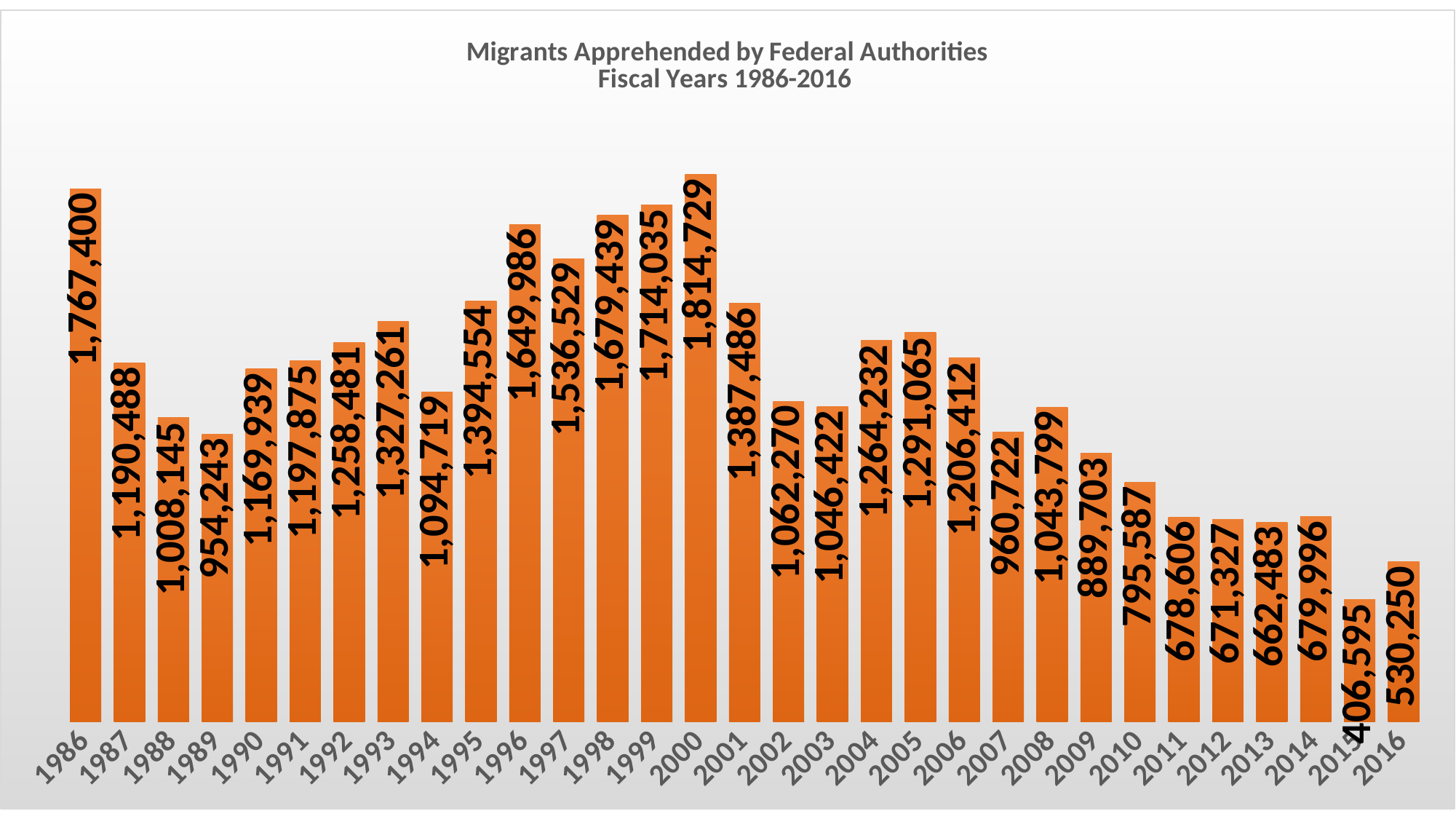
What is the difference between the values for 2015 and 2016? 123,655 Which year has the lowest value? 2015 How many years are shown on the x axis? 31 What is the value for 1986? 1,767,400 What is the value for 2000? 1,814,729 Which year has the highest value? 2000 Do the values generally rise or fall from 2000 to 2016? fall Which is larger, the value for 1996 or the value for 1997? 1996 What kind of chart is this? bar chart What is the title of the chart? Migrants Apprehended by Federal Authorities Fiscal Years 1986-2016 What is the difference between the values for 2000 and 2016? 1,284,479 What is the value for 2015? 406,595